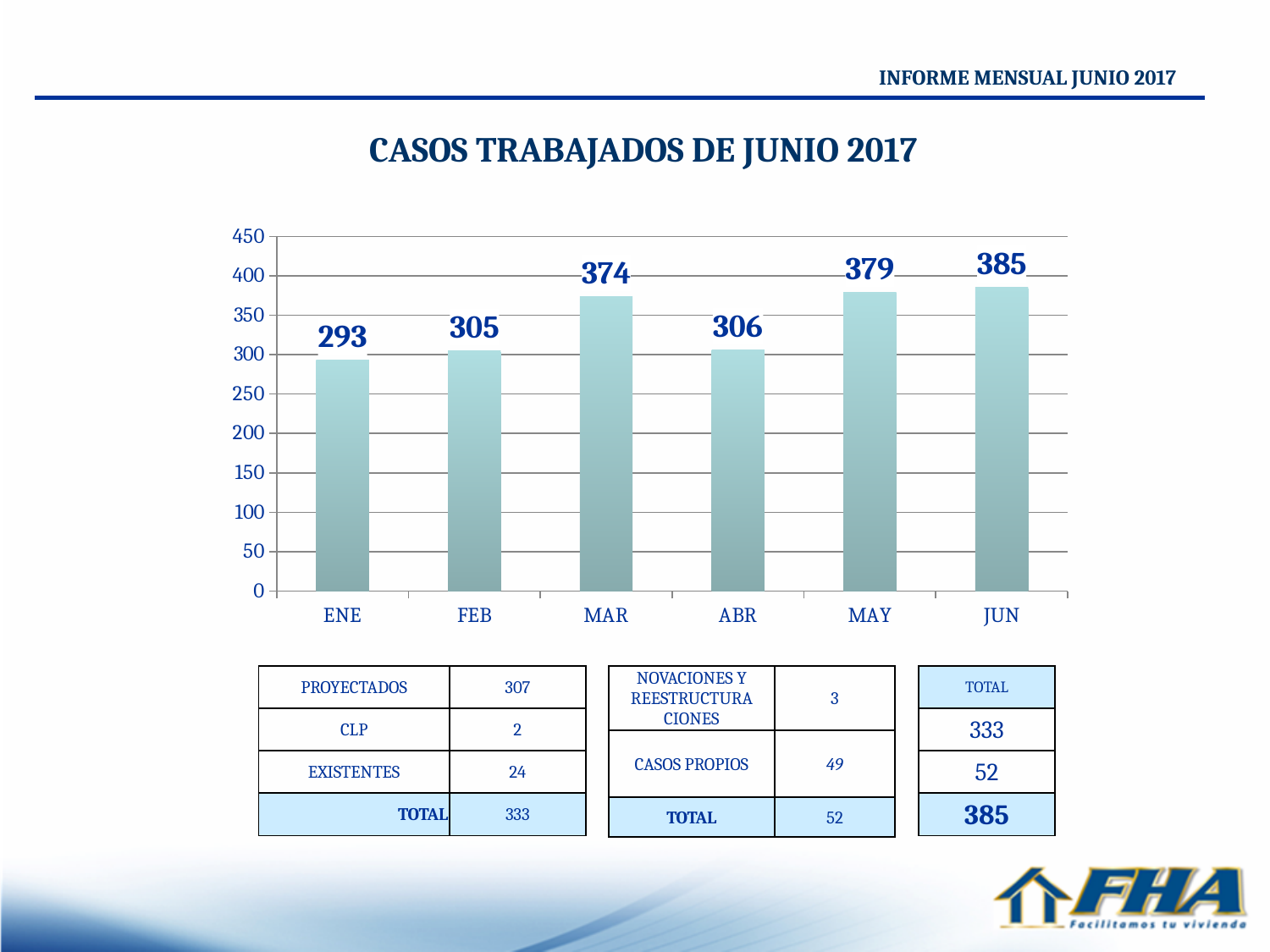
What is the difference between the values for MAR and ABR? 68 What kind of chart is shown on the slide? bar chart Which month has the lowest value? ENE Which is larger, the value for FEB or the value for MAY? MAY What is the value for MAR? 374 What is the title of the chart? CASOS TRABAJADOS DE JUNIO 2017 What is the value for JUN? 385 Is the value for ABR greater or less than 350? less How many months are shown on the x axis? 6 What is the difference between the values for JUN and MAY? 6 Which month has the highest value? JUN What is the value for ENE? 293